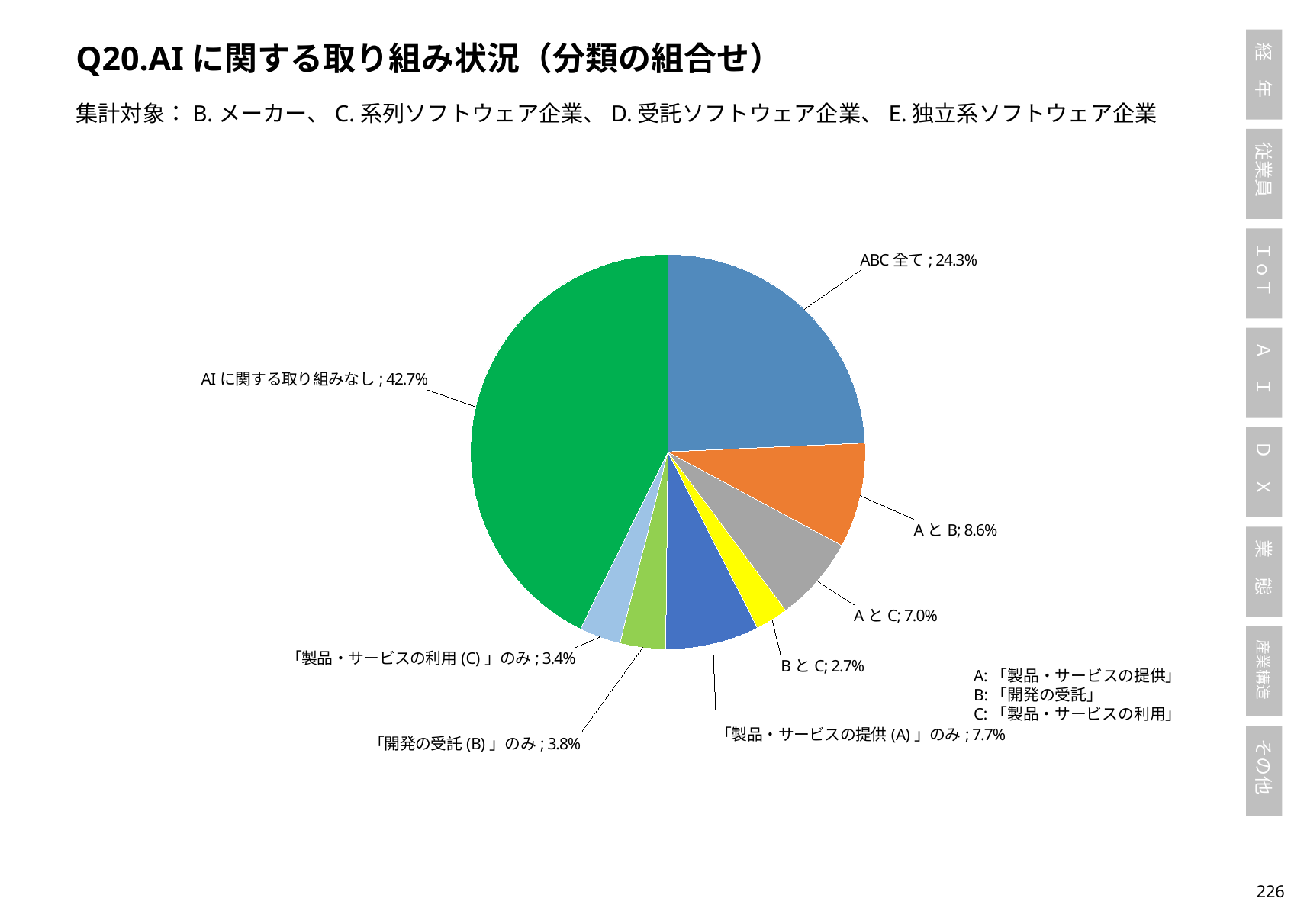
Which is larger, 「A と C」 or 「製品・サービスの提供 (A) 」のみ? 「製品・サービスの提供 (A) 」のみ How many slices does the pie chart have? 8 Which category has the largest share of the pie? AI に関する取り組みなし What is the value for 「AI に関する取り組みなし」? 42.7% What is the value for 「製品・サービスの提供 (A) 」のみ? 7.7% Which category has the smallest share of the pie? B と C What is the value for 「B と C」? 2.7% What is the value for 「ABC 全て」? 24.3% What type of chart is shown on the slide? pie chart What is the value for 「A と B」? 8.6% What colour is the slice for 「AI に関する取り組みなし」? green What is the difference between 「AI に関する取り組みなし」 and 「ABC 全て」? 18.4%